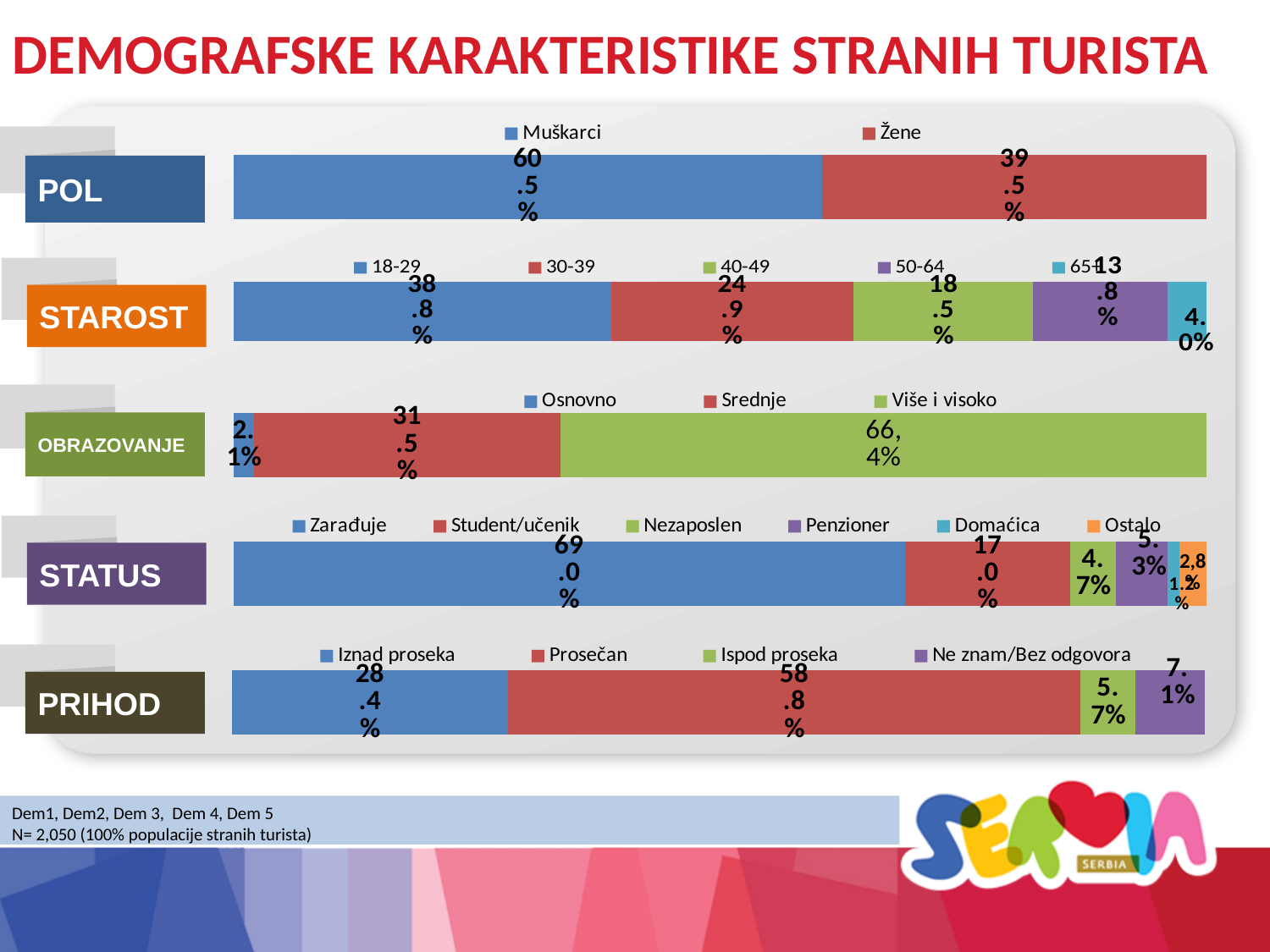
What kind of chart is used for the PRIHOD row? Stacked bar chart In the POL chart, what is the value for Žene? 39.5% In the STATUS chart, what is the value for Zarađuje? 69.0% In the OBRAZOVANJE chart, what is the value for Više i visoko? 66,4% In the STAROST chart, how many age groups does the legend list? 5 In the POL chart, what is the value for Muškarci? 60.5% In the STATUS chart, which is larger, Nezaposlen or Penzioner? Penzioner In the STAROST chart, which age group has the highest share? 18-29 In the STAROST chart, which age group has the lowest share? 65+ In the STAROST chart, what is the value for the 30-39 age group? 24.9% In the OBRAZOVANJE chart, what is the difference between Srednje and Osnovno? 29.4% In the PRIHOD chart, what is the value for Prosečan? 58.8%